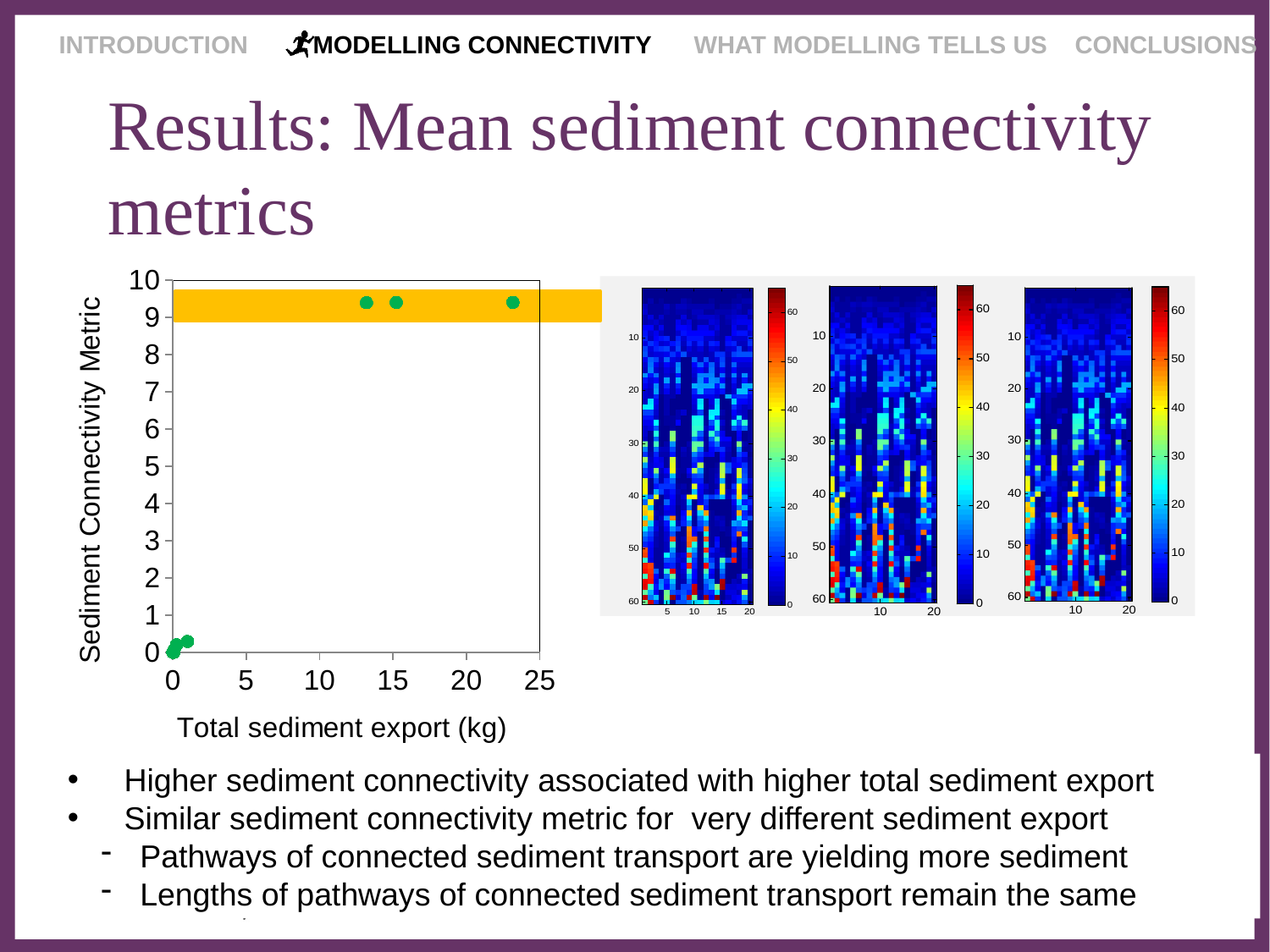
In the scatter chart on the left, do points with higher Total sediment export have higher or lower Sediment Connectivity Metric? higher In the scatter chart on the left, what is the label of the x axis? Total sediment export (kg) In the scatter chart on the left, what is the label of the y axis? Sediment Connectivity Metric In the scatter chart on the left, what is the highest tick value shown on the y axis? 10 In the scatter chart on the left, is the Total sediment export of the rightmost point greater or less than 20? greater What kind of chart is shown on the left of the slide? scatter chart In the scatter chart on the left, is the Sediment Connectivity Metric of the points near the origin greater or less than 1? less In the scatter chart on the left, is the Total sediment export of the points near the origin greater or less than 5? less How many heatmap panels are shown on the right side of the slide? 3 In the scatter chart on the left, what is the highest tick value shown on the x axis? 25 In the scatter chart on the left, how many points have a Sediment Connectivity Metric above 9? 3